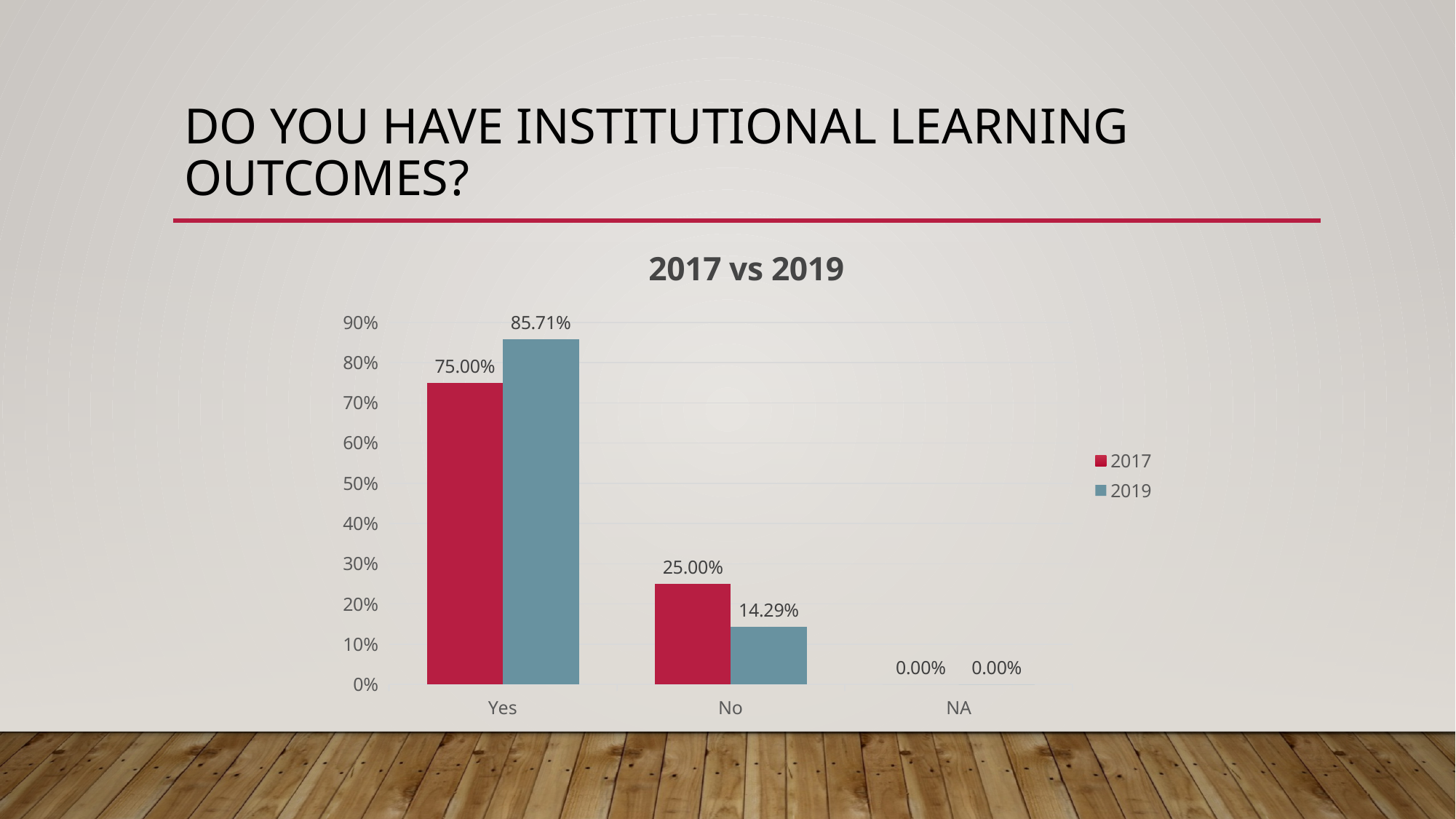
What kind of chart is shown on the slide? Bar chart What is the value for NA in the 2017 series? 0.00% How many categories are shown on the x axis? 3 What is the title of the chart? 2017 vs 2019 Which category has the lowest value in the 2017 series? NA What is the value for Yes in the 2019 series? 85.71% What is the value for No in the 2019 series? 14.29% Which category has the highest value in the 2019 series? Yes What is the value for Yes in the 2017 series? 75.00% Which is larger for No: the 2017 value or the 2019 value? 2017 What is the difference between the 2019 and 2017 values for Yes? 10.71% How many series does the legend list? 2